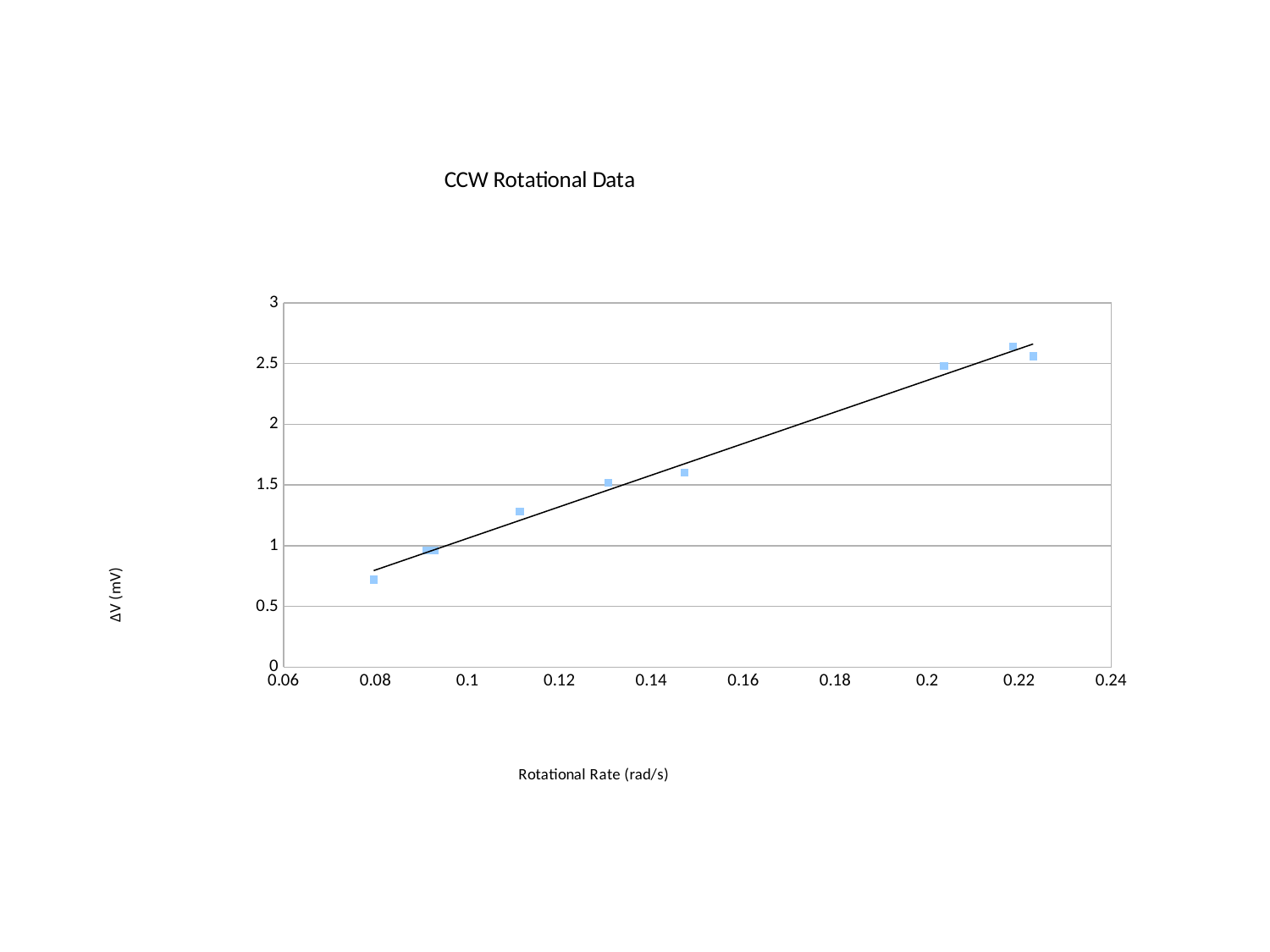
Is the ΔV value for the leftmost data point (near 0.08 rad/s) greater or less than 1? less What kind of chart is shown on the slide? scatter chart What is the title of the chart? CCW Rotational Data Is the ΔV value for the data point near 0.147 rad/s greater or less than 1.5? greater Which has the larger ΔV: the data point near 0.08 rad/s or the data point near 0.2 rad/s? the data point near 0.2 rad/s Is the ΔV value for the data point near 0.11 rad/s greater or less than 1.5? less Do the ΔV values rise or fall as the rotational rate increases? rise What is the label of the x axis? Rotational Rate (rad/s)